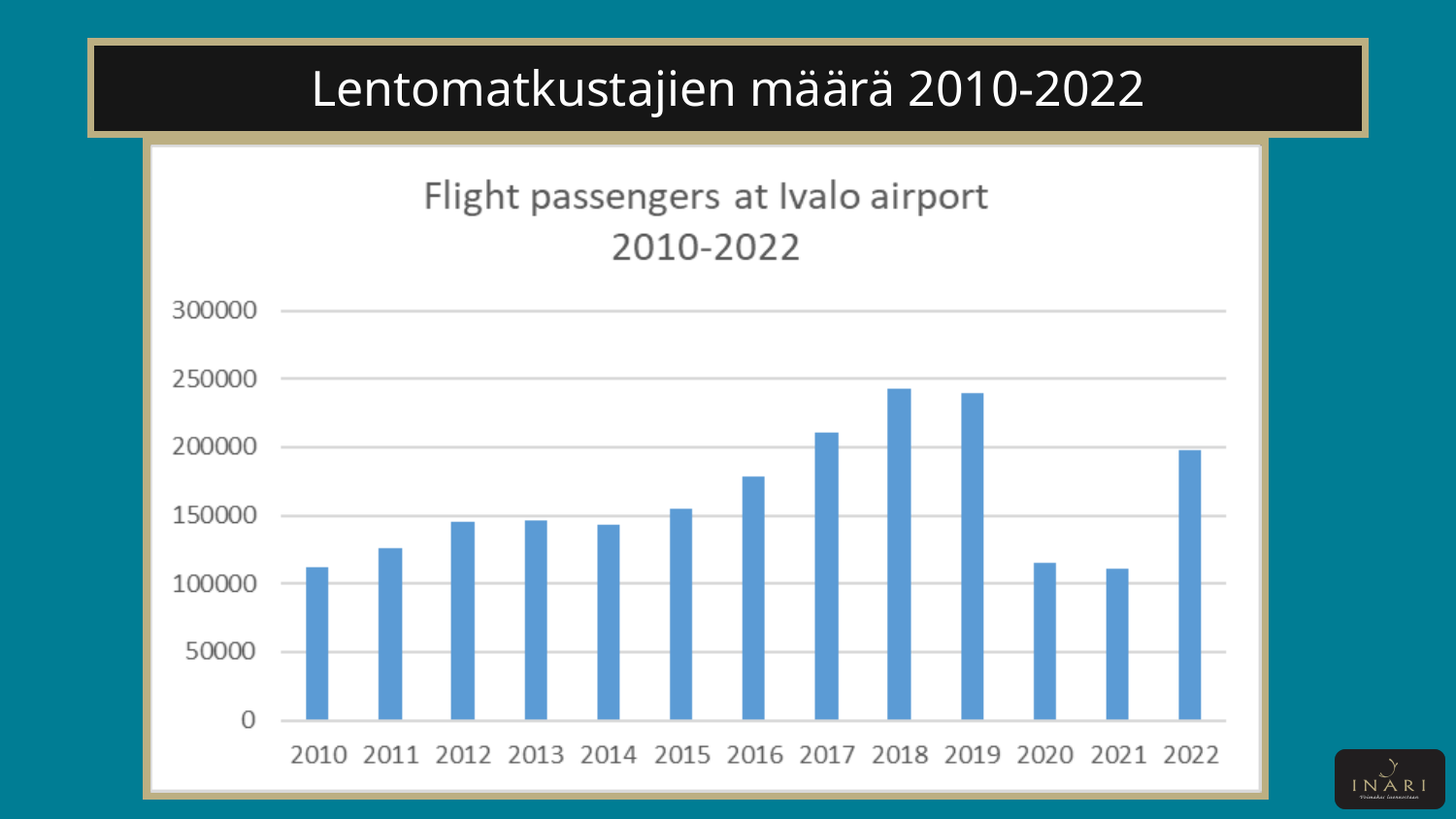
Is the value for 2020 greater or less than 150000? less How many years are plotted on the x axis of the chart? 13 Which year has the larger value, 2022 or 2021? 2022 Is the value for 2016 greater or less than 150000? greater Do the values rise or fall from 2014 to 2018? rise What is the title of the chart? Flight passengers at Ivalo airport 2010-2022 Which year has the larger value, 2018 or 2020? 2018 Is the value for 2018 greater or less than 200000? greater Which year has the highest number of flight passengers? 2018 What kind of chart is shown on the slide? bar chart